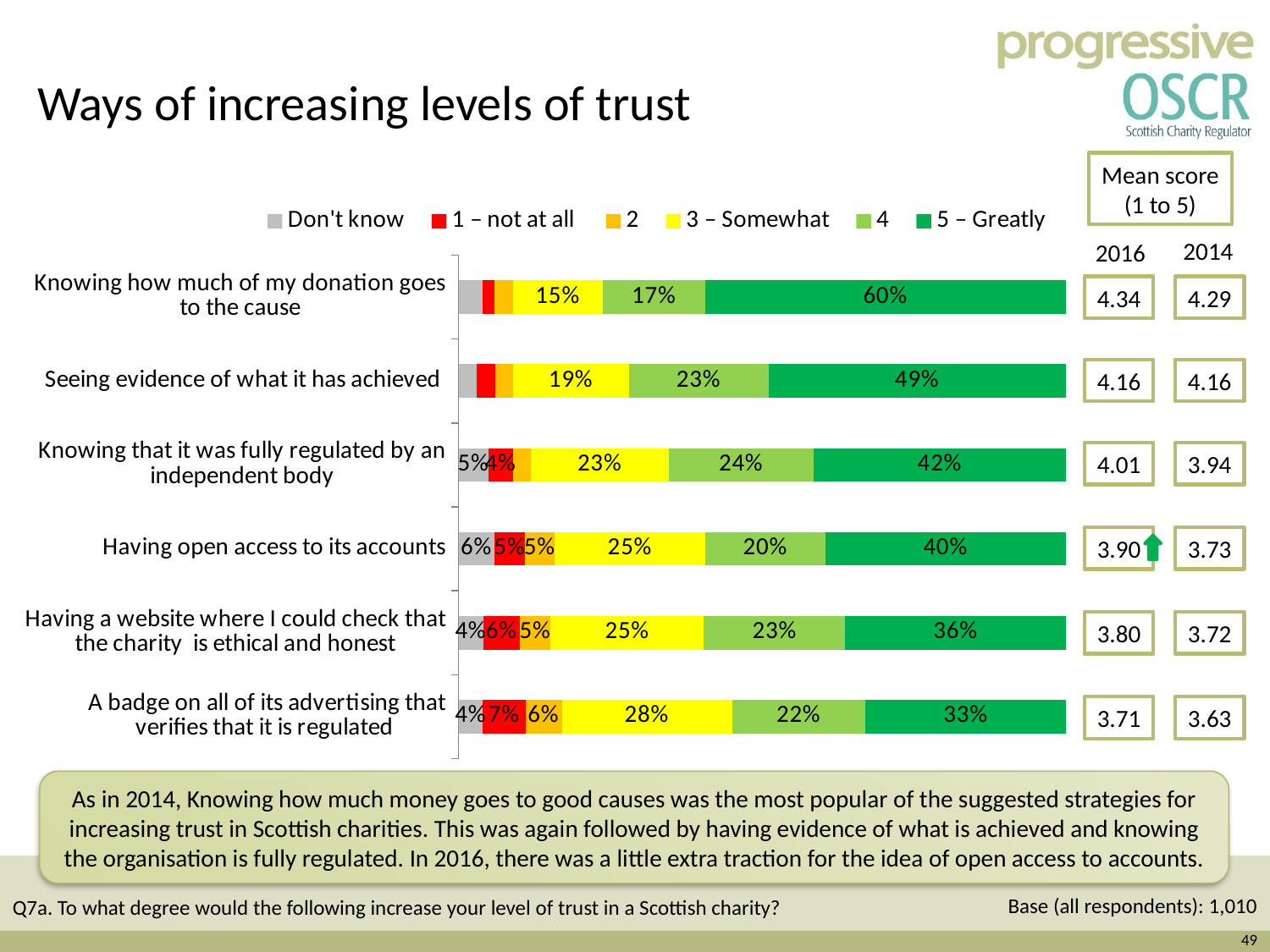
Which legend entry is shown in red? 1 – not at all What is the '4' value for 'Knowing that it was fully regulated by an independent body'? 24% What percentage of respondents said 'Knowing how much of my donation goes to the cause' would increase their trust greatly (5)? 60% Which category has the highest '5 – Greatly' percentage? Knowing how much of my donation goes to the cause How many series does the chart legend list? 6 How many categories (ways of increasing trust) are plotted on the chart? 6 What is the '3 – Somewhat' value for 'A badge on all of its advertising that verifies that it is regulated'? 28% What is the difference in the '5 – Greatly' percentage between 'Knowing how much of my donation goes to the cause' and 'Seeing evidence of what it has achieved'? 11 percentage points What is the '1 – not at all' value for 'A badge on all of its advertising that verifies that it is regulated'? 7% Which has a larger '5 – Greatly' percentage: 'Having open access to its accounts' or 'Having a website where I could check that the charity is ethical and honest'? Having open access to its accounts Which category has the lowest '5 – Greatly' percentage? A badge on all of its advertising that verifies that it is regulated What kind of chart is shown on the slide? Stacked bar chart